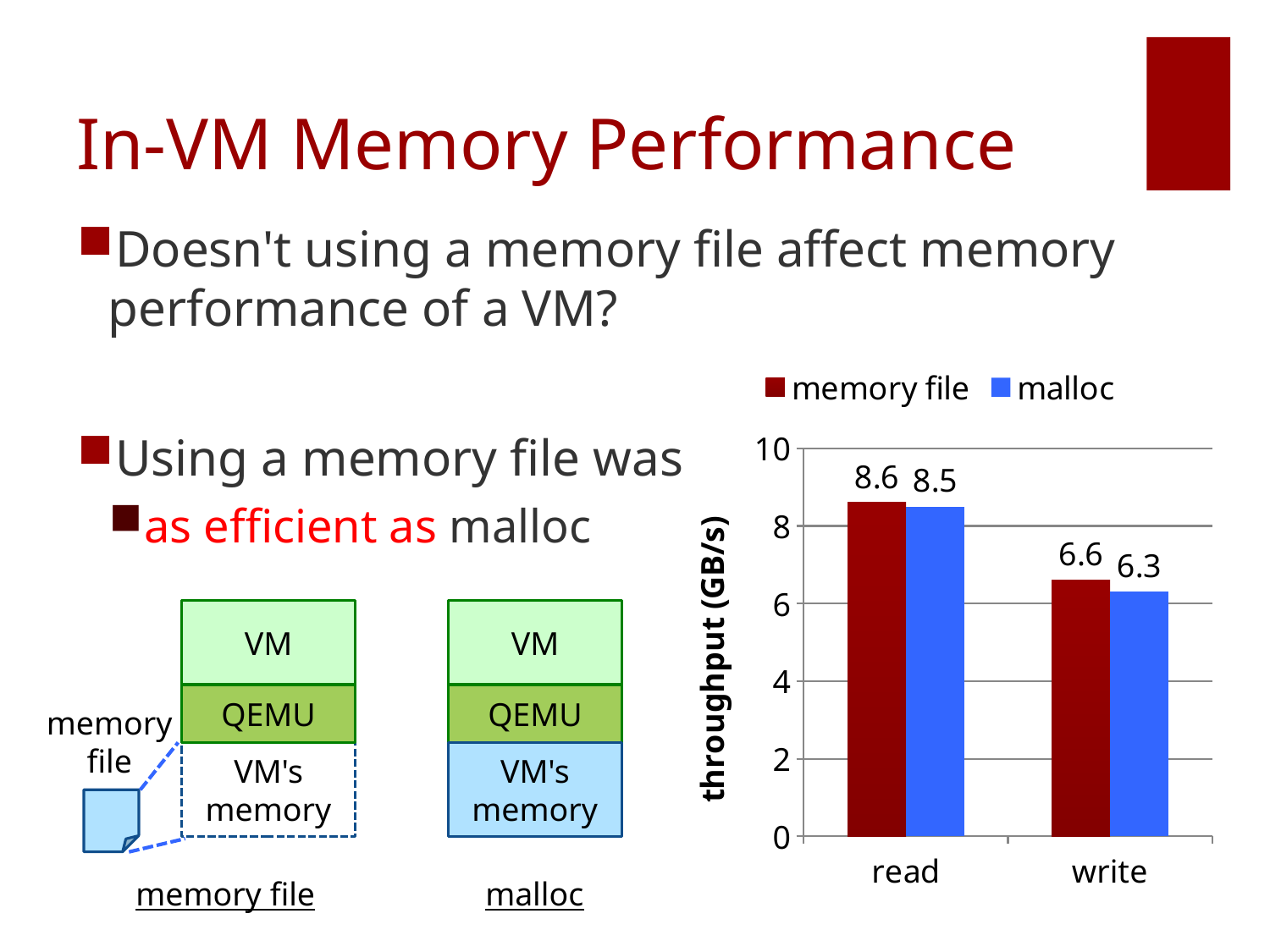
How many categories are shown on the x axis of the chart? 2 What is the difference between the memory file read throughput and the memory file write throughput? 2 What is the difference between the memory file and malloc throughput in the write category? 0.3 Which category has the lowest malloc throughput? write What is the throughput for malloc in the write category? 6.3 Which is larger: the memory file throughput for read or the memory file throughput for write? read What is the throughput for memory file in the read category? 8.6 What is the throughput for memory file in the write category? 6.6 Which category has the highest memory file throughput? read How many series does the chart legend list? 2 What is the label of the y axis of the chart? throughput (GB/s) What is the throughput for malloc in the read category? 8.5